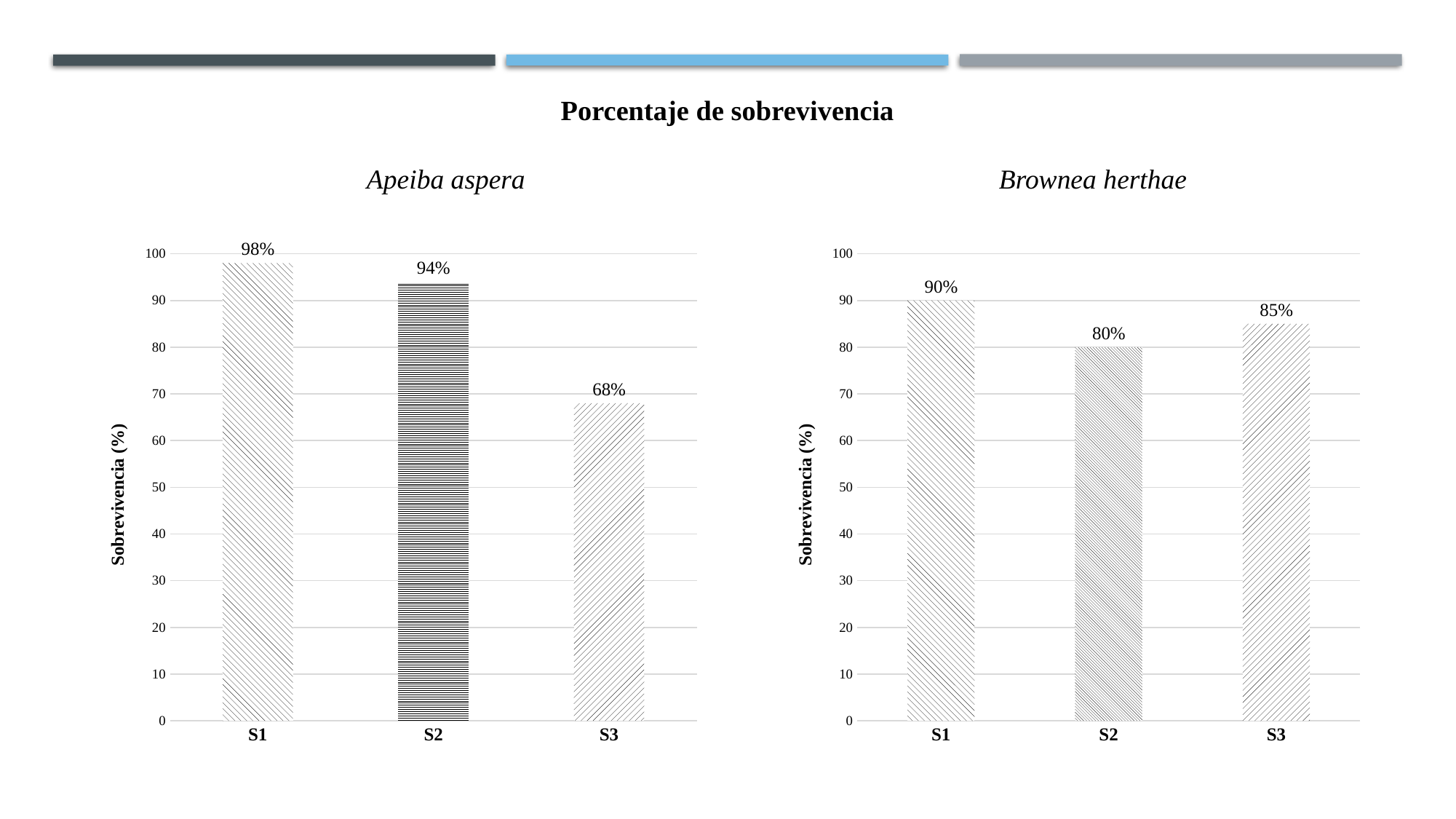
How many categories are shown in the Apeiba aspera chart? 3 In the Brownea herthae chart, which category has the highest survival? S1 What is the y-axis label of the Apeiba aspera chart? Sobrevivencia (%) What kind of chart is the Brownea herthae chart? Bar chart In the Brownea herthae chart, what is the survival value for S3? 85% In the Apeiba aspera chart, what is the survival value for S1? 98% In the Apeiba aspera chart, what is the difference between the S1 and S3 values? 30% In the Brownea herthae chart, which is larger, the value for S2 or the value for S3? S3 In the Apeiba aspera chart, what is the survival value for S3? 68% In the Brownea herthae chart, what is the survival value for S2? 80% In the Brownea herthae chart, what is the difference between the S1 and S2 values? 10% In the Apeiba aspera chart, which category has the lowest survival? S3